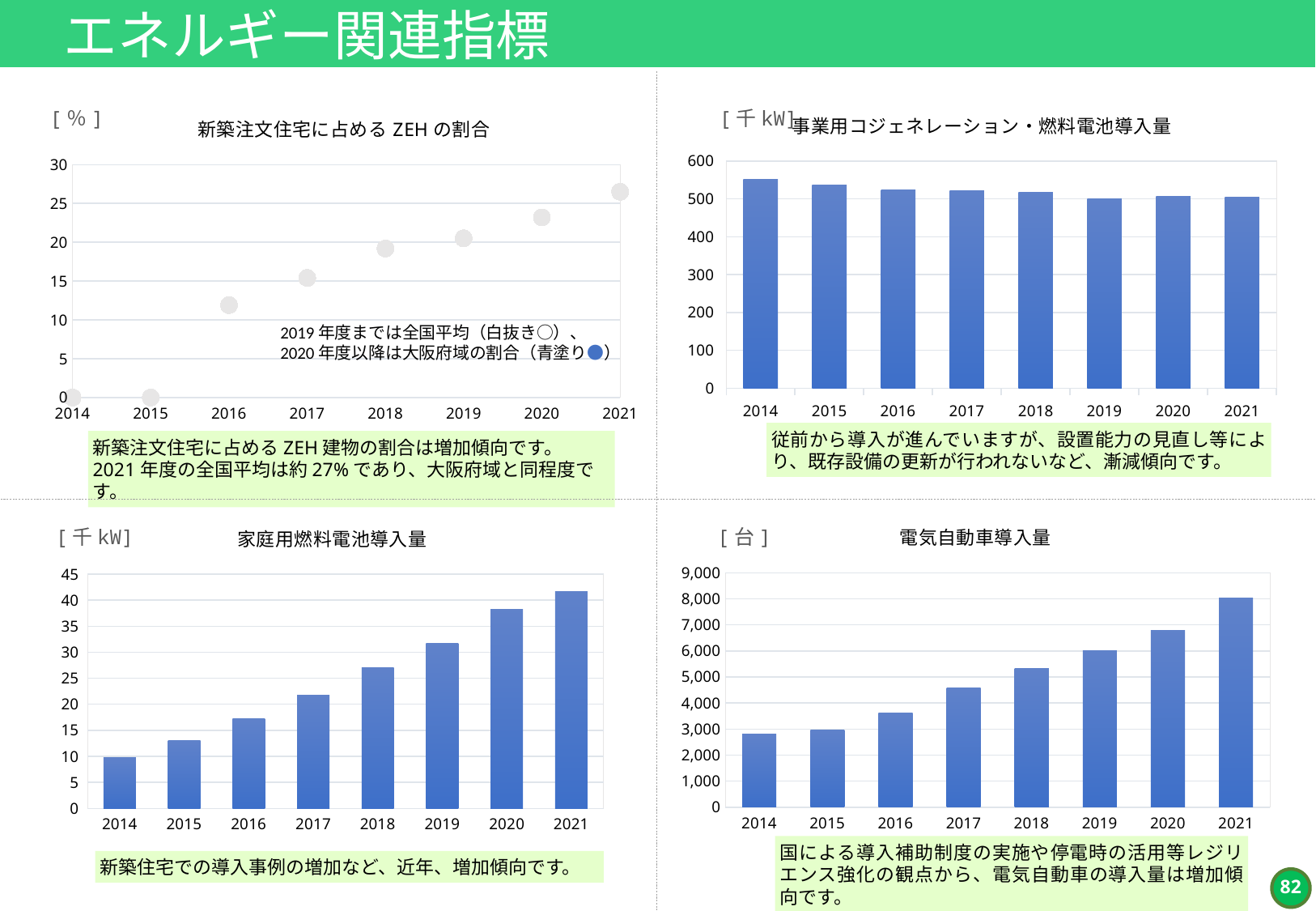
In the 事業用コジェネレーション・燃料電池導入量 chart (top right), which year has the highest value? 2014 In the 新築注文住宅に占めるZEHの割合 chart (top left), do the values rise or fall from 2014 to 2021? rise In the 家庭用燃料電池導入量 chart (bottom left), is the value for 2021 greater or less than 40? greater How many years are shown on the x axis of the 電気自動車導入量 chart (bottom right)? 8 In the 家庭用燃料電池導入量 chart (bottom left), which year has the lowest value? 2014 In the 新築注文住宅に占めるZEHの割合 chart (top left), is the value for 2016 greater or less than 10? greater In the 電気自動車導入量 chart (bottom right), which year has the highest value? 2021 In the 事業用コジェネレーション・燃料電池導入量 chart (top right), is the value for 2014 greater or less than 500? greater In the 家庭用燃料電池導入量 chart (bottom left), which is larger, the value for 2018 or the value for 2016? 2018 What kind of chart is the 事業用コジェネレーション・燃料電池導入量 chart (top right)? bar chart